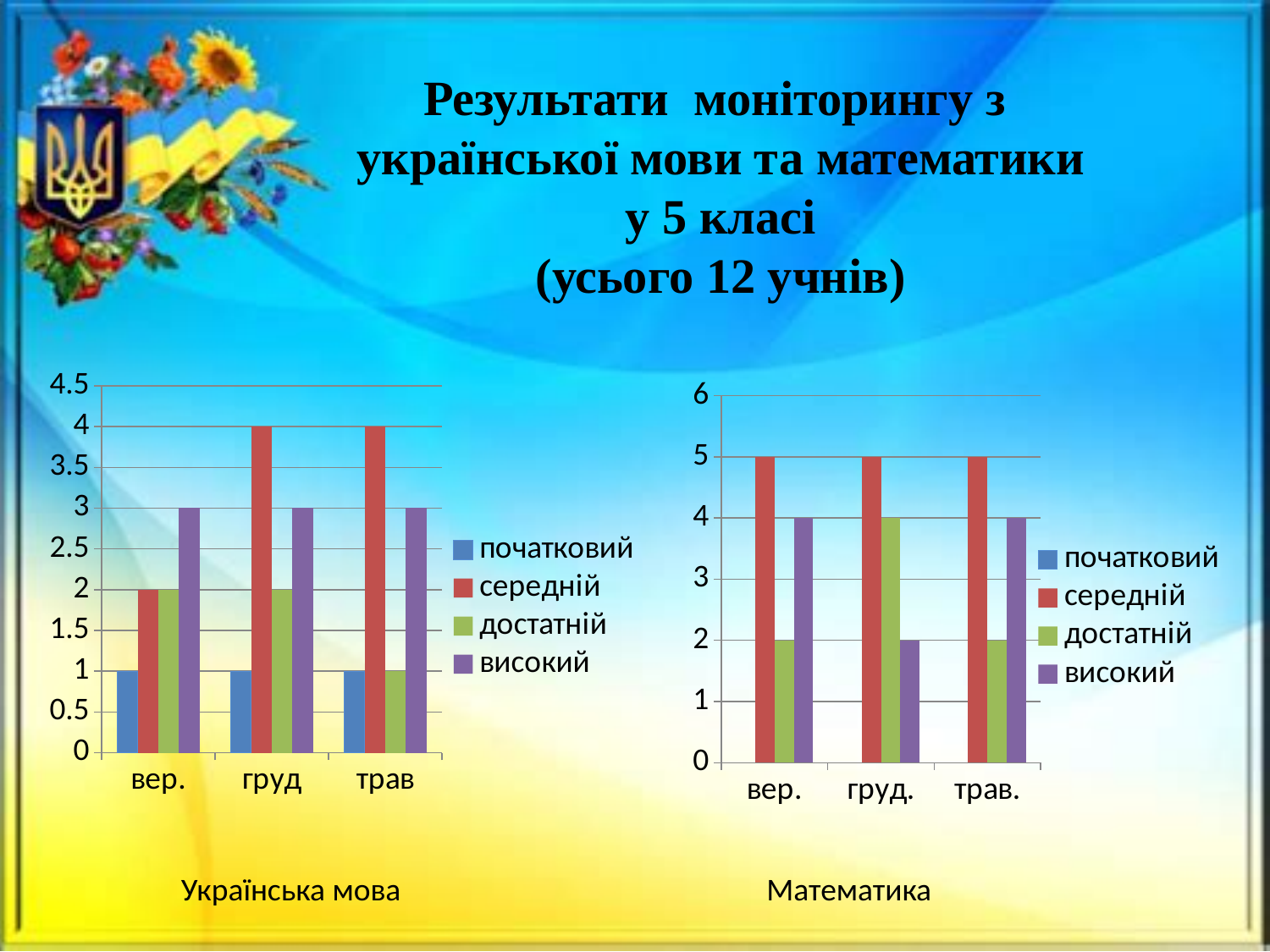
In the Математика chart, what is the value of достатній for груд.? 4 In the Математика chart, what is the value of середній for вер.? 5 In the Українська мова chart, what is the value of середній for груд? 4 In the Українська мова chart, how many series does the legend list? 4 In the Українська мова chart, how many categories are shown on the x axis? 3 In the Математика chart, is the value of високий for трав. larger or smaller than the value of достатній for трав.? larger What type of chart is the Математика chart? bar chart In the Математика chart, which series has the lowest value for груд.? високий In the Українська мова chart, what is the difference between середній and початковий for трав? 3 In the Українська мова chart, which series has the highest value for трав? середній In the Українська мова chart, what is the value of високий for вер.? 3 In the Математика chart, what colour represents the середній series? red